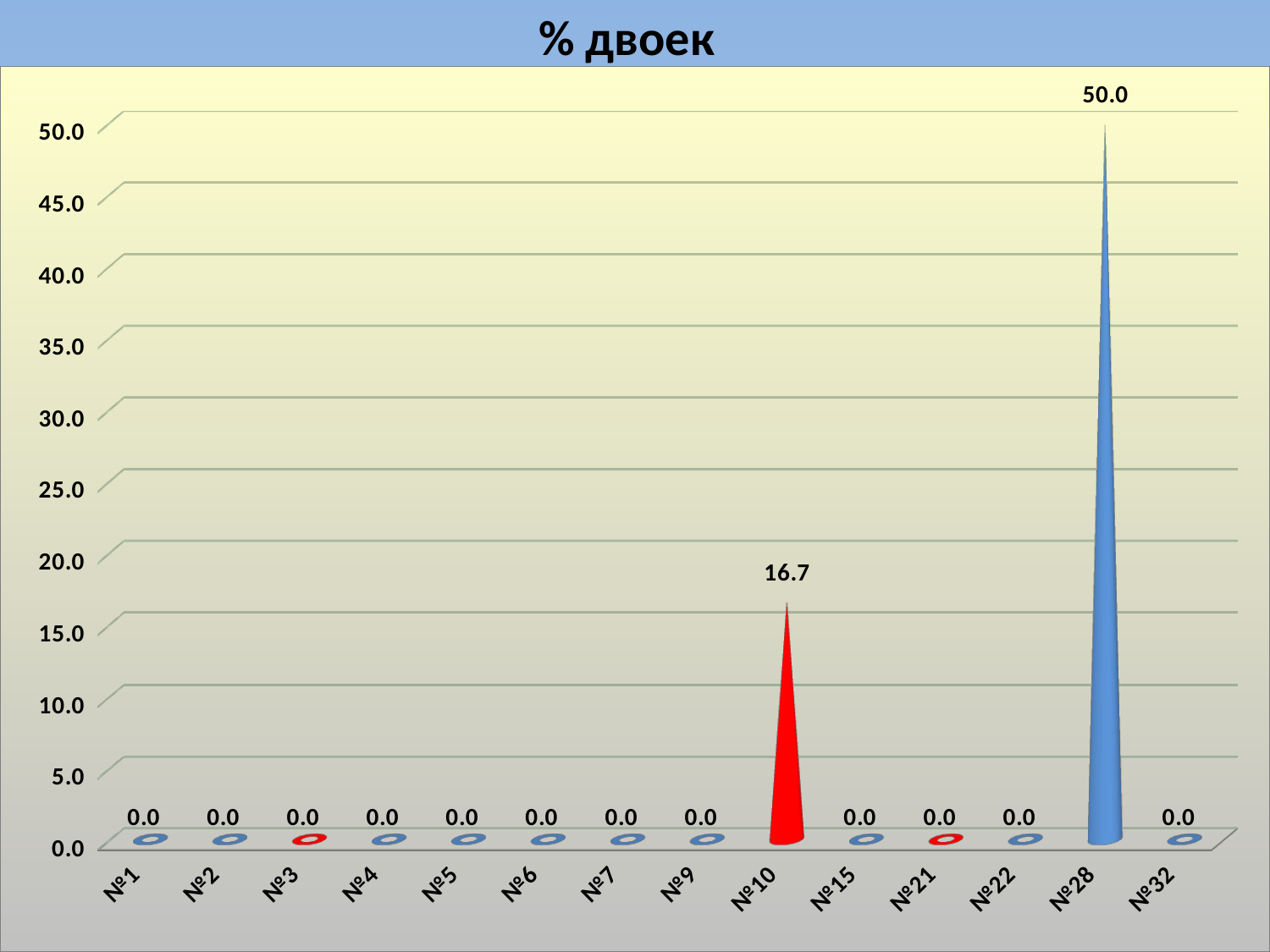
What is the difference between the values for №28 and №10? 33.3 What is the title of the chart? % двоек How many categories are shown on the x axis? 14 What is the value for №10? 16.7 Which category has the highest value? №28 Is the value for №10 greater or less than 20.0? less What is the value for №28? 50.0 How many categories have a value of 0.0? 12 What is the value for №15? 0.0 Which is larger, the value for №10 or the value for №28? №28 Is the value for №28 greater or less than 45.0? greater What kind of chart is this? bar chart